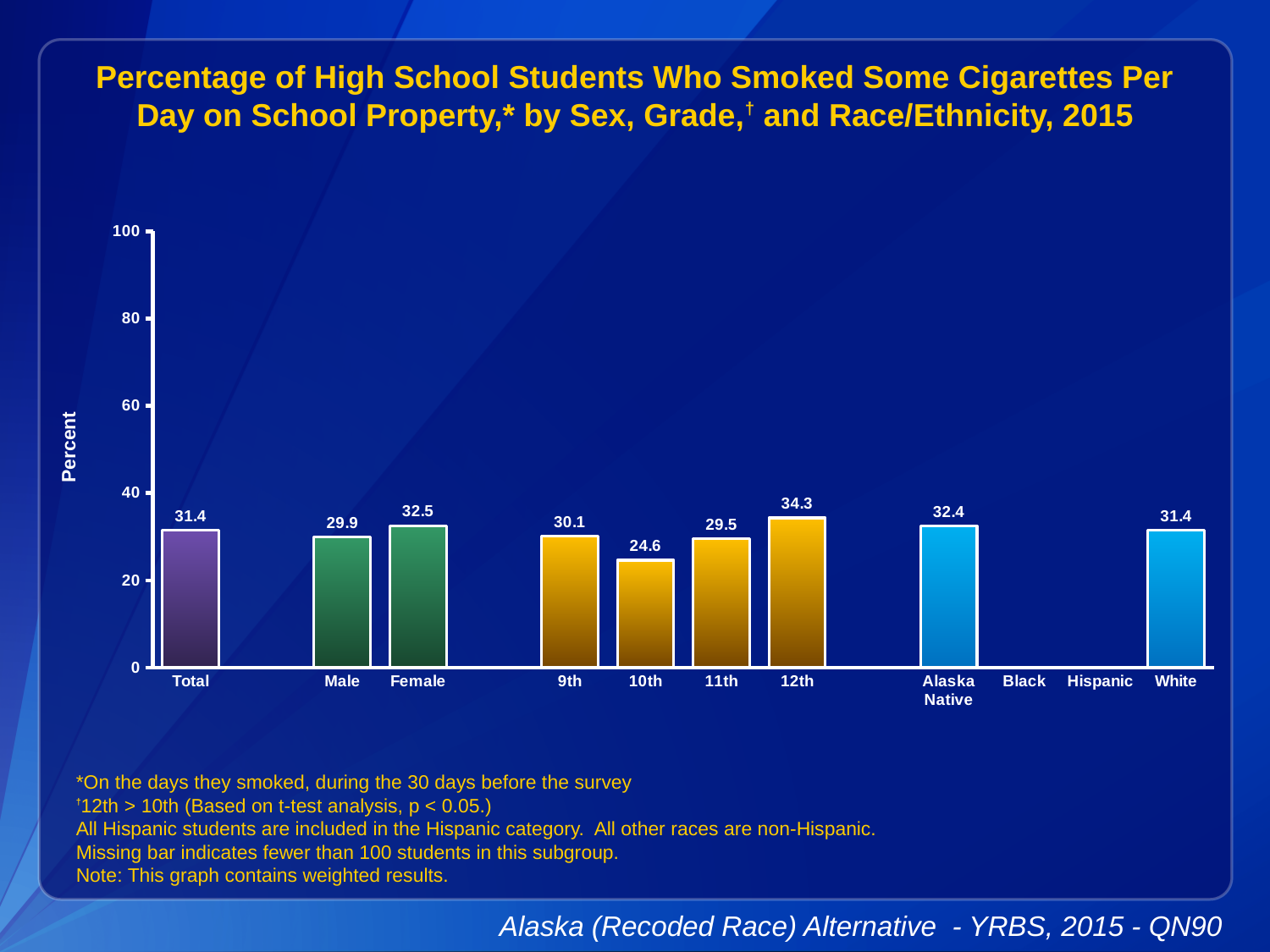
Which category has the lowest value? 10th What is the value for Alaska Native? 32.4 Which is larger, the value for 9th grade or 11th grade? 9th What is the label on the y axis? Percent Is the value for 12th grade greater or less than 40? less What is the difference between the Female and Male values? 2.6 Which category has the highest value? 12th What kind of chart is this? bar chart What is the value for 10th grade? 24.6 What is the value for Total? 31.4 What is the difference between the 12th and 10th grade values? 9.7 How many categories have a bar plotted? 9